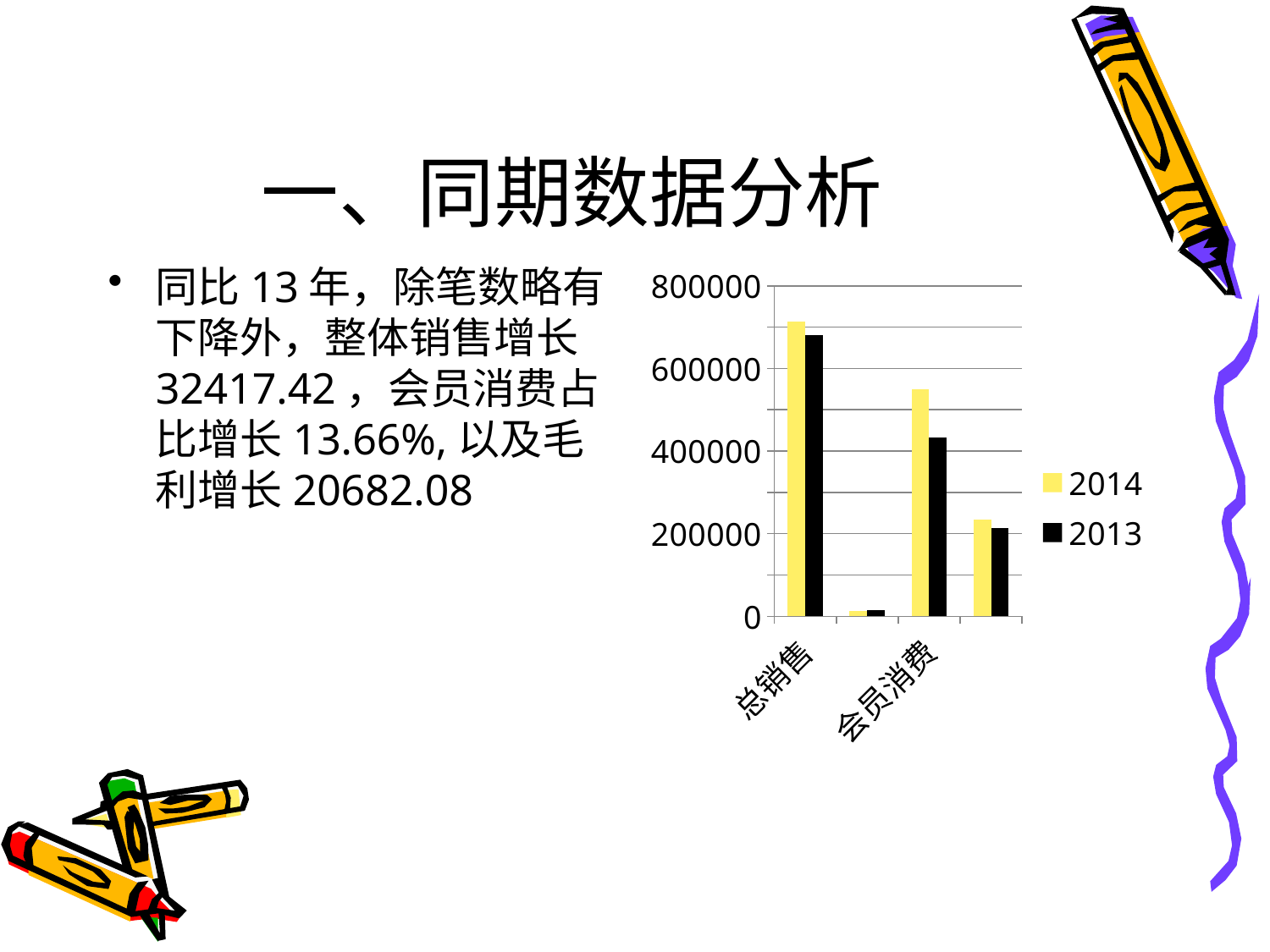
For 会员消费, which year has the larger value, 2014 or 2013? 2014 What kind of chart is shown on the slide? bar chart Is the 2013 value for 会员消费 greater or less than 400000? greater Is the 2014 value for 总销售 greater or less than 600000? greater Is the 2013 value for 总销售 greater or less than 600000? greater How many series does the chart legend list? 2 How many groups of bars are plotted in the chart? 4 Which colour represents the 2014 series in the chart? yellow Which labelled category has the highest 2014 value? 总销售 For 总销售, which year has the larger value, 2014 or 2013? 2014 Which two series are listed in the chart legend? 2014 and 2013